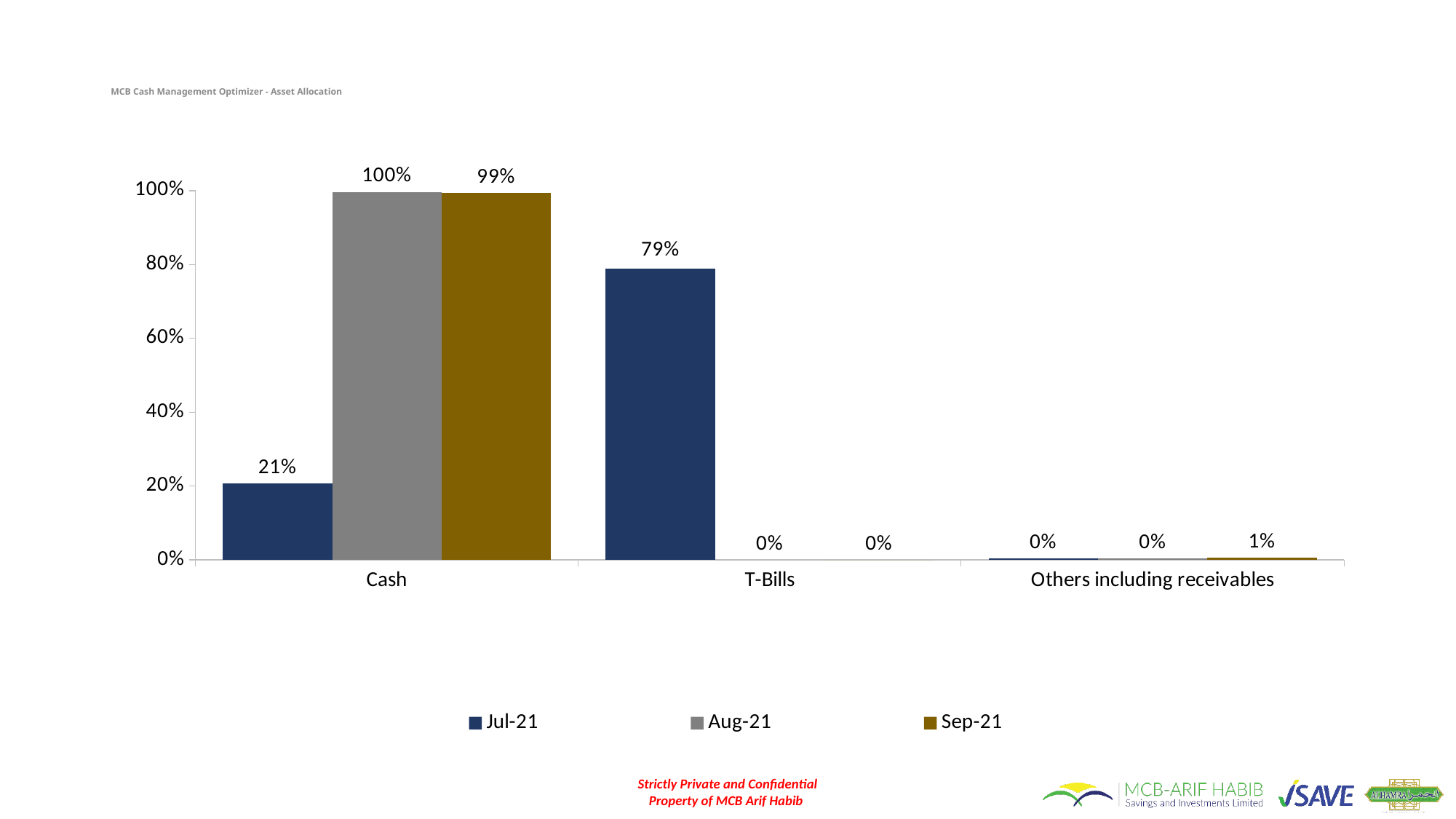
How many series does the legend list? 3 What is the title of the chart? MCB Cash Management Optimizer - Asset Allocation What is the difference between the Aug-21 and Jul-21 values for Cash? 79% What is the Sep-21 value for Cash? 99% Which is larger for Cash: the Jul-21 value or the Sep-21 value? Sep-21 Which category has the highest Jul-21 value? T-Bills How many categories are shown on the x axis? 3 What is the Jul-21 value for T-Bills? 79% What is the Aug-21 value for Cash? 100% What is the Jul-21 value for Cash? 21% What is the Sep-21 value for Others including receivables? 1% What kind of chart is shown on the slide? Bar chart